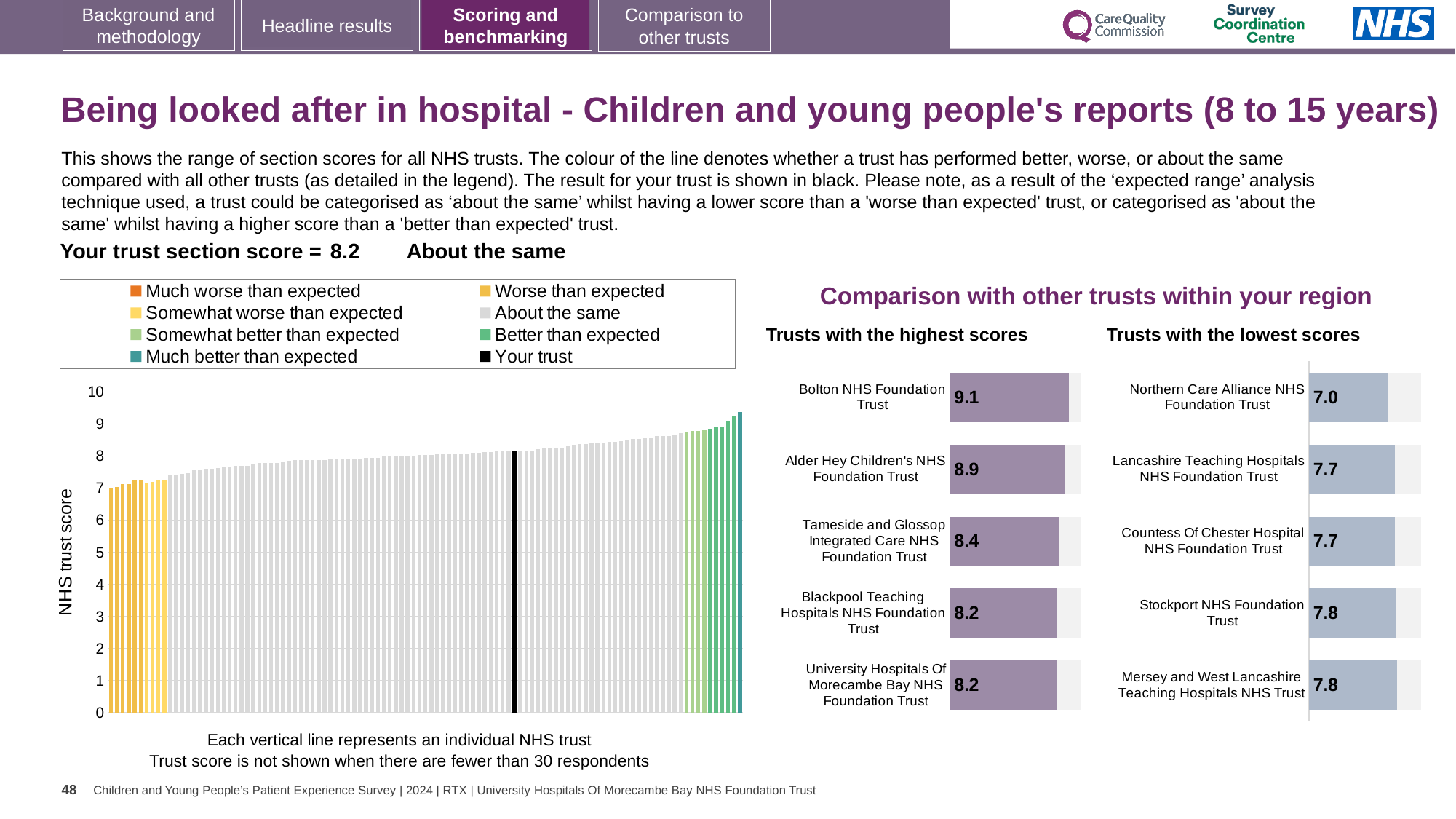
How many entries does the legend of the 'NHS trust score' chart on the left list? 8 In the 'Trusts with the highest scores' chart, which has the higher score: Tameside and Glossop Integrated Care NHS Foundation Trust or Blackpool Teaching Hospitals NHS Foundation Trust? Tameside and Glossop Integrated Care NHS Foundation Trust In the 'Trusts with the highest scores' chart, what is the score for Bolton NHS Foundation Trust? 9.1 In the 'Trusts with the lowest scores' chart, how much higher is Stockport NHS Foundation Trust's score than Northern Care Alliance NHS Foundation Trust's score? 0.8 In the 'Trusts with the highest scores' chart, what is the difference between the scores of Bolton NHS Foundation Trust and Alder Hey Children's NHS Foundation Trust? 0.2 In the 'Trusts with the lowest scores' chart, which trust has the lowest score? Northern Care Alliance NHS Foundation Trust In the 'Trusts with the lowest scores' chart, what is the score for Countess Of Chester Hospital NHS Foundation Trust? 7.7 In the 'Trusts with the highest scores' chart, which trust has the highest score? Bolton NHS Foundation Trust In the 'NHS trust score' chart on the left, do the bar values rise or fall from left to right? rise How many trusts are shown in the 'Trusts with the highest scores' chart? 5 In the 'Trusts with the lowest scores' chart, what is the score for Northern Care Alliance NHS Foundation Trust? 7.0 What kind of chart is the 'NHS trust score' chart on the left of the slide? bar chart